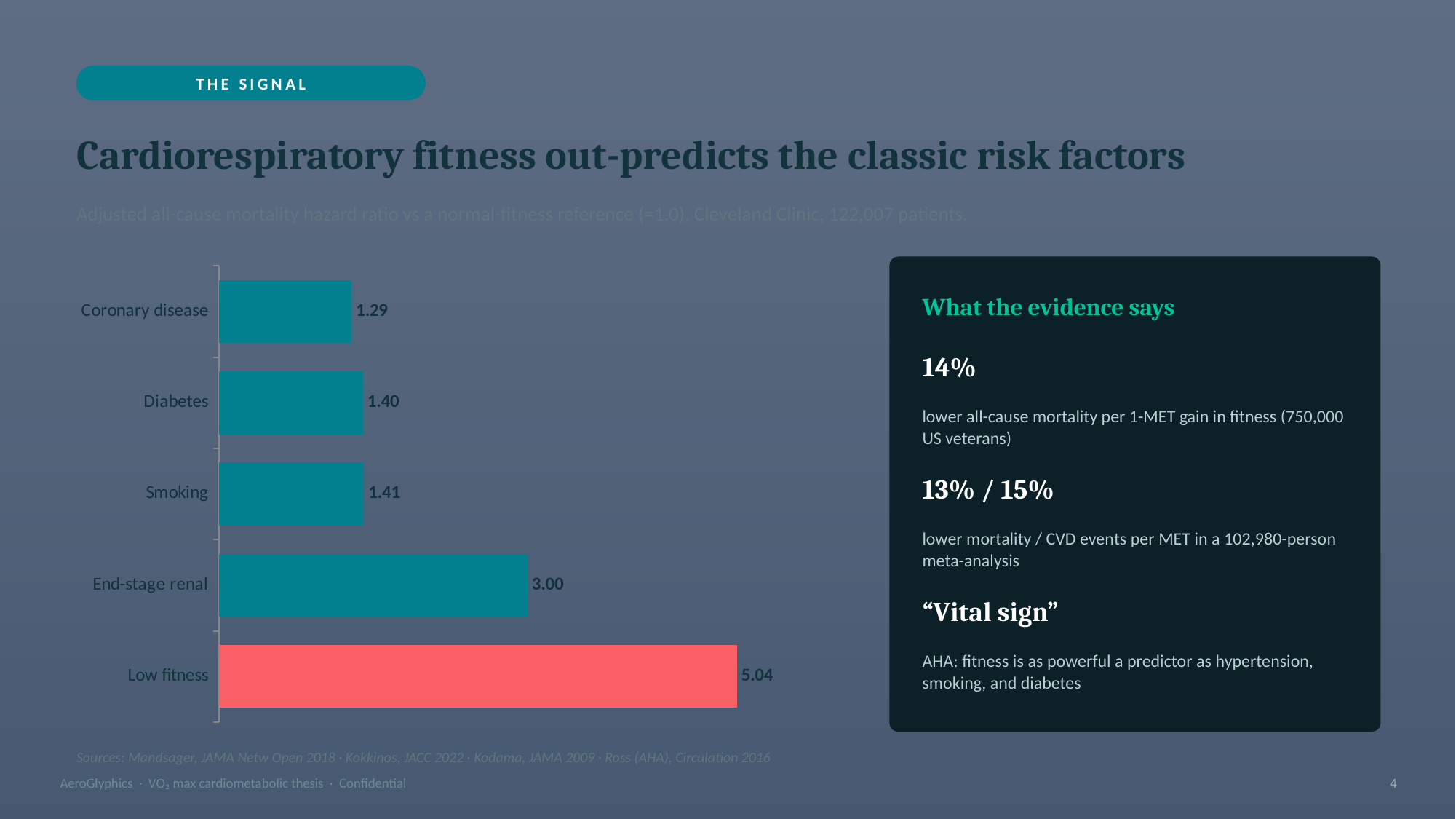
Which bar is coloured differently (red) from the others? Low fitness What is the hazard ratio shown for Diabetes? 1.40 What is the difference between the hazard ratios for Low fitness and End-stage renal? 2.04 What kind of chart is shown on the slide? Bar chart What is the difference between the hazard ratios for Smoking and Coronary disease? 0.12 Which category has the lowest hazard ratio? Coronary disease What is the hazard ratio shown for Coronary disease? 1.29 How many categories are plotted in the chart? 5 Which has a larger hazard ratio, End-stage renal or Diabetes? End-stage renal What is the hazard ratio shown for Low fitness? 5.04 What is the hazard ratio shown for End-stage renal? 3.00 Which category has the highest hazard ratio? Low fitness